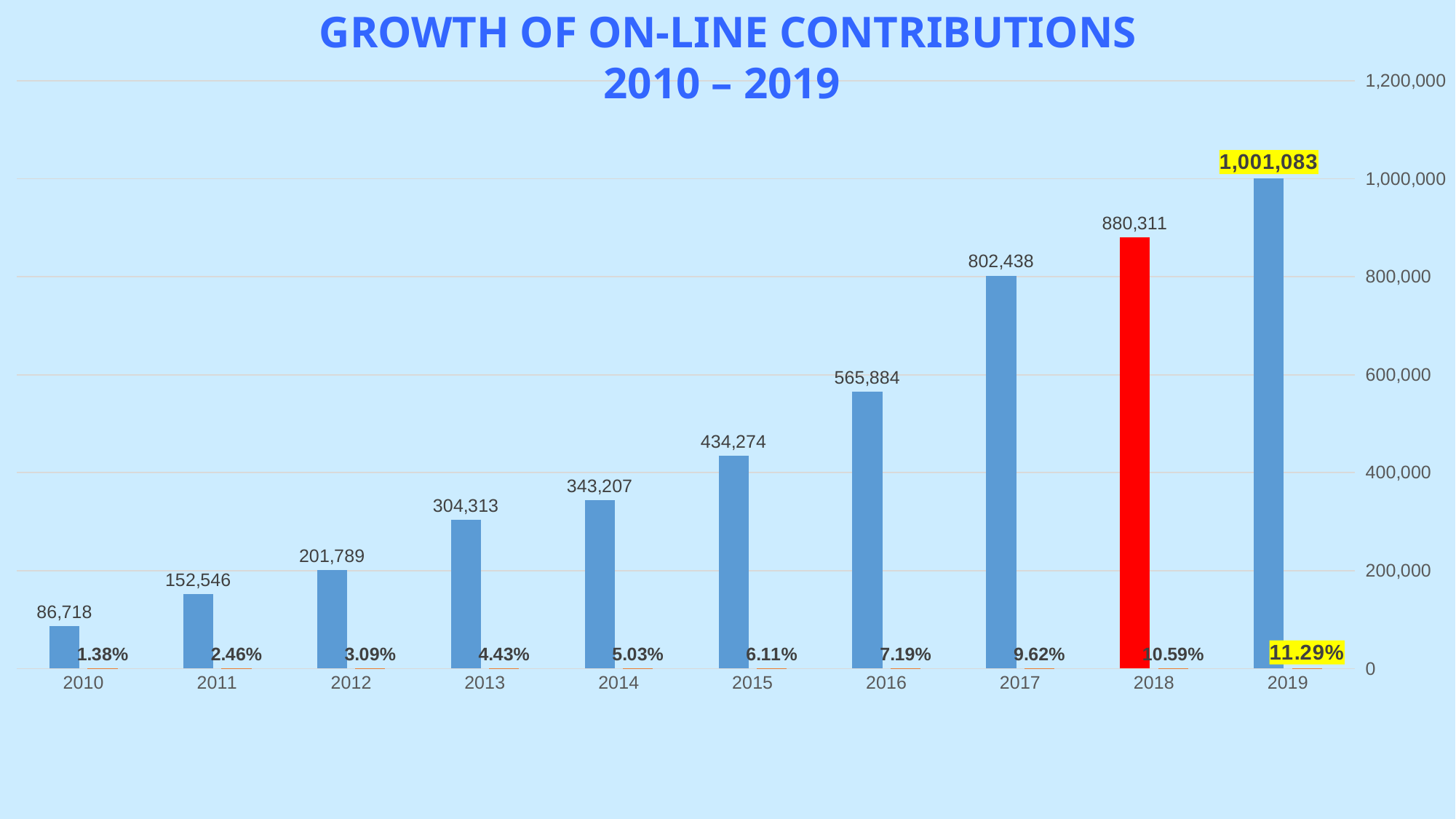
Do on-line contributions rise or fall from 2010 to 2019? rise What is the value of on-line contributions for 2018? 880,311 Which year has higher on-line contributions, 2014 or 2016? 2016 Is the value for 2017 greater or less than 800,000? greater Which year has the highest on-line contributions? 2019 What kind of chart is this? bar chart What is the value of on-line contributions for 2015? 434,274 What is the difference in on-line contributions between 2019 and 2018? 120,772 How many years are shown on the x axis? 10 Which year has the lowest on-line contributions? 2010 Which year's bar is coloured red? 2018 What percentage is shown for 2013? 4.43%